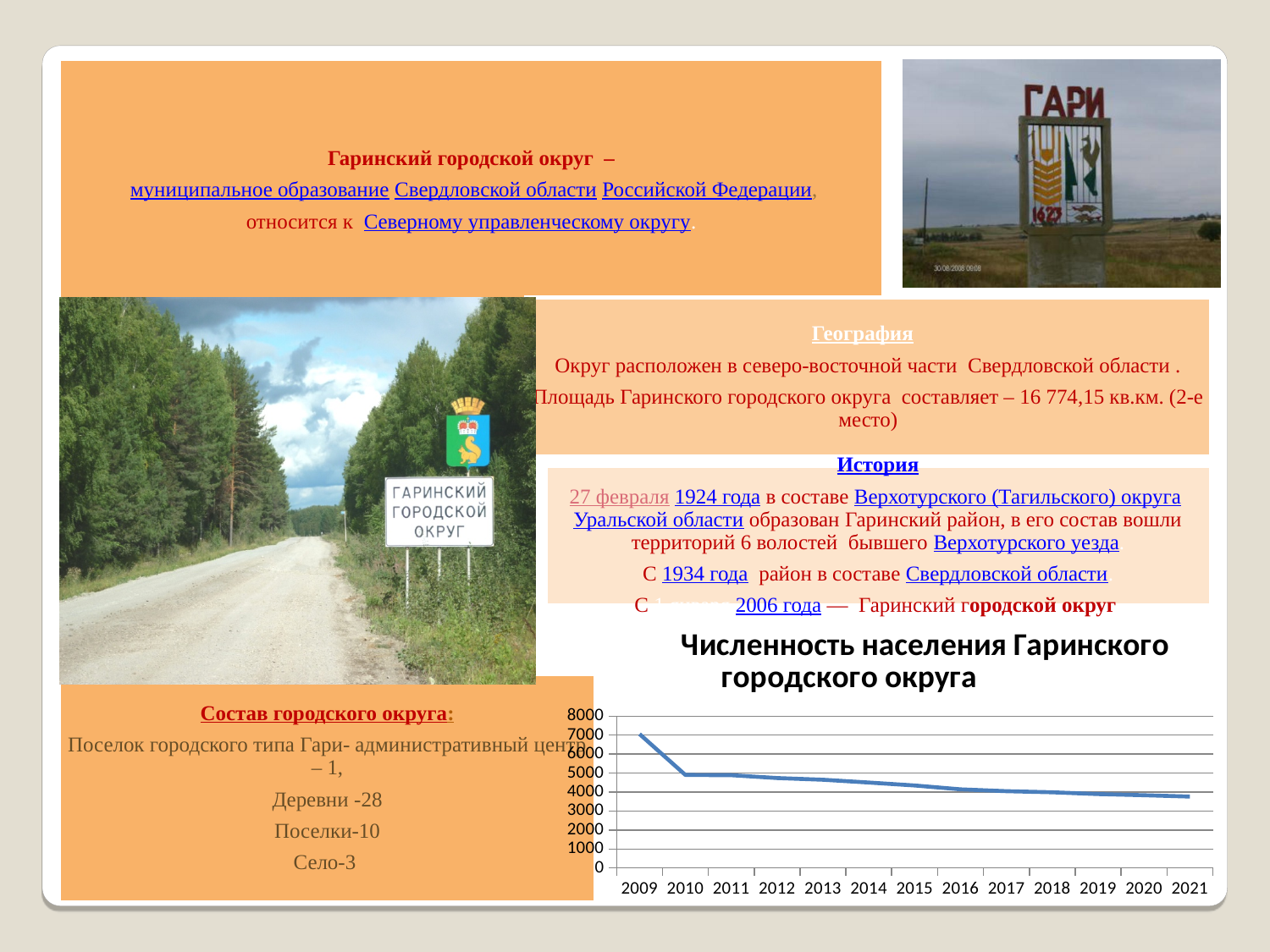
What kind of chart is shown under the title 'Численность населения Гаринского городского округа'? line chart Is the population value for 2010 greater or less than 6000? less Is the population value for 2009 greater or less than 6000? greater Is the population value for 2021 greater or less than 4000? less How many years are plotted on the x axis of the population chart? 13 What is the title of the chart on the slide? Численность населения Гаринского городского округа What is the highest tick value shown on the y axis of the population chart? 8000 Which year has the highest population value in the chart? 2009 Which year has the larger population value, 2009 or 2021? 2009 Which year has the lowest population value in the chart? 2021 Does the population value rise or fall from 2009 to 2021 in the chart? fall